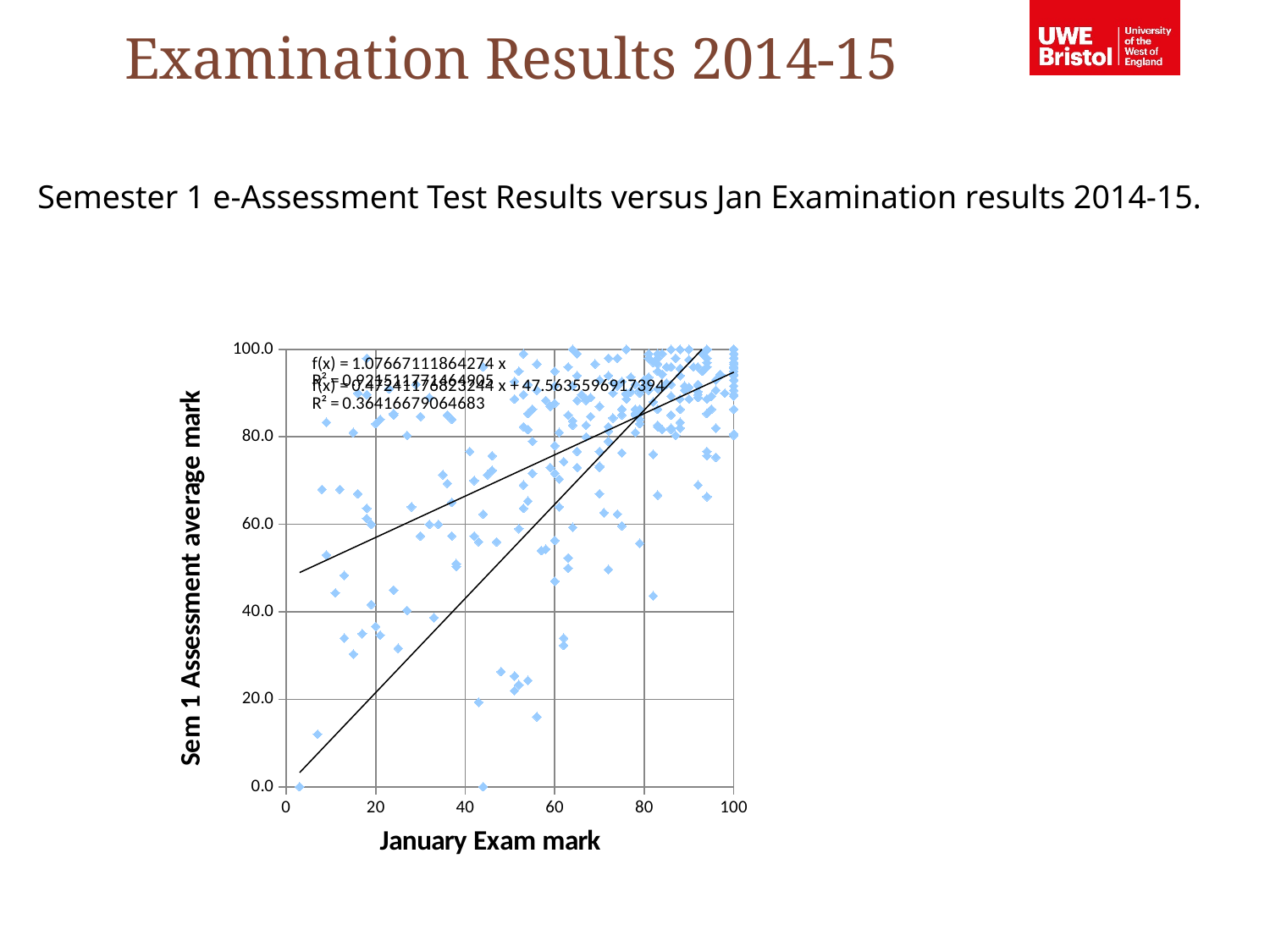
What is the R² value printed below the equation f(x) = 0.472411768232441 x + 47.5635596917394? 0.36416679064683 What is the slope of the trendline whose equation is f(x) = 0.472411768232441 x + 47.5635596917394? 0.472411768232441 What is the title of the y axis of the chart? Sem 1 Assessment average mark What kind of chart is shown on the slide? scatter chart As the January Exam mark increases along the x axis, do the Sem 1 Assessment average marks generally rise or fall? rise What is the lowest Sem 1 Assessment average mark plotted on the chart? 0.0 What is the highest Sem 1 Assessment average mark plotted on the chart? 100.0 What is the slope of the trendline whose equation is f(x) = 1.07667111864274 x? 1.07667111864274 What is the intercept of the trendline whose equation is f(x) = 0.472411768232441 x + 47.5635596917394? 47.5635596917394 How many trendlines are drawn on the chart? 2 What is the title of the x axis of the chart? January Exam mark